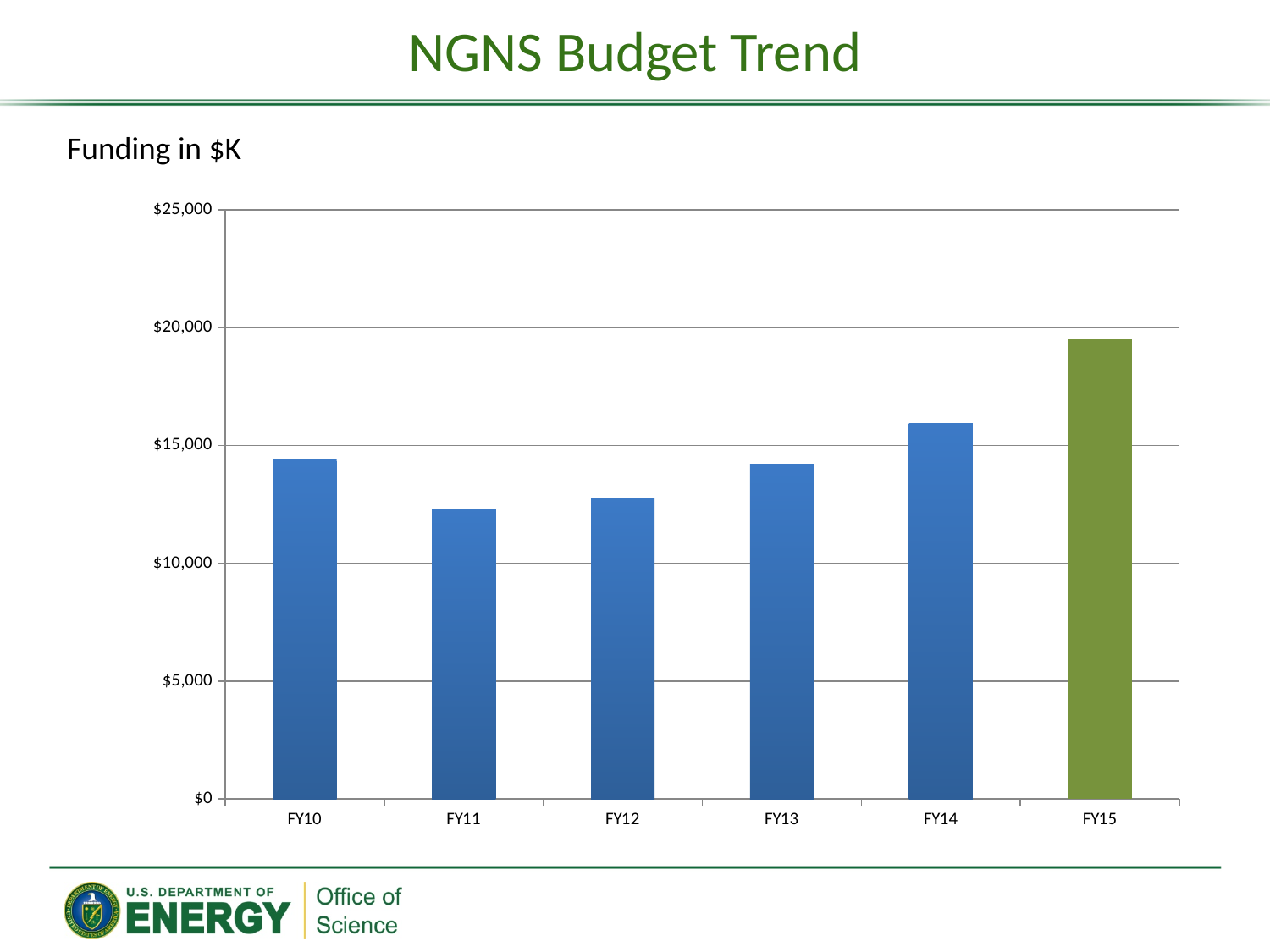
Is the value for FY11 greater or less than $15,000? less Which is larger, the value for FY15 or the value for FY14? FY15 Which is larger, the value for FY14 or the value for FY10? FY14 Is the value for FY15 greater or less than $20,000? less Which bar is shown in a different colour (green) from the others? FY15 How many fiscal years are plotted on the chart? 6 Is the value for FY10 greater or less than $10,000? greater What kind of chart is shown on the slide? bar chart From FY12 to FY15, do the values rise or fall? rise Which fiscal year has the highest funding? FY15 Which fiscal year has the lowest funding? FY11